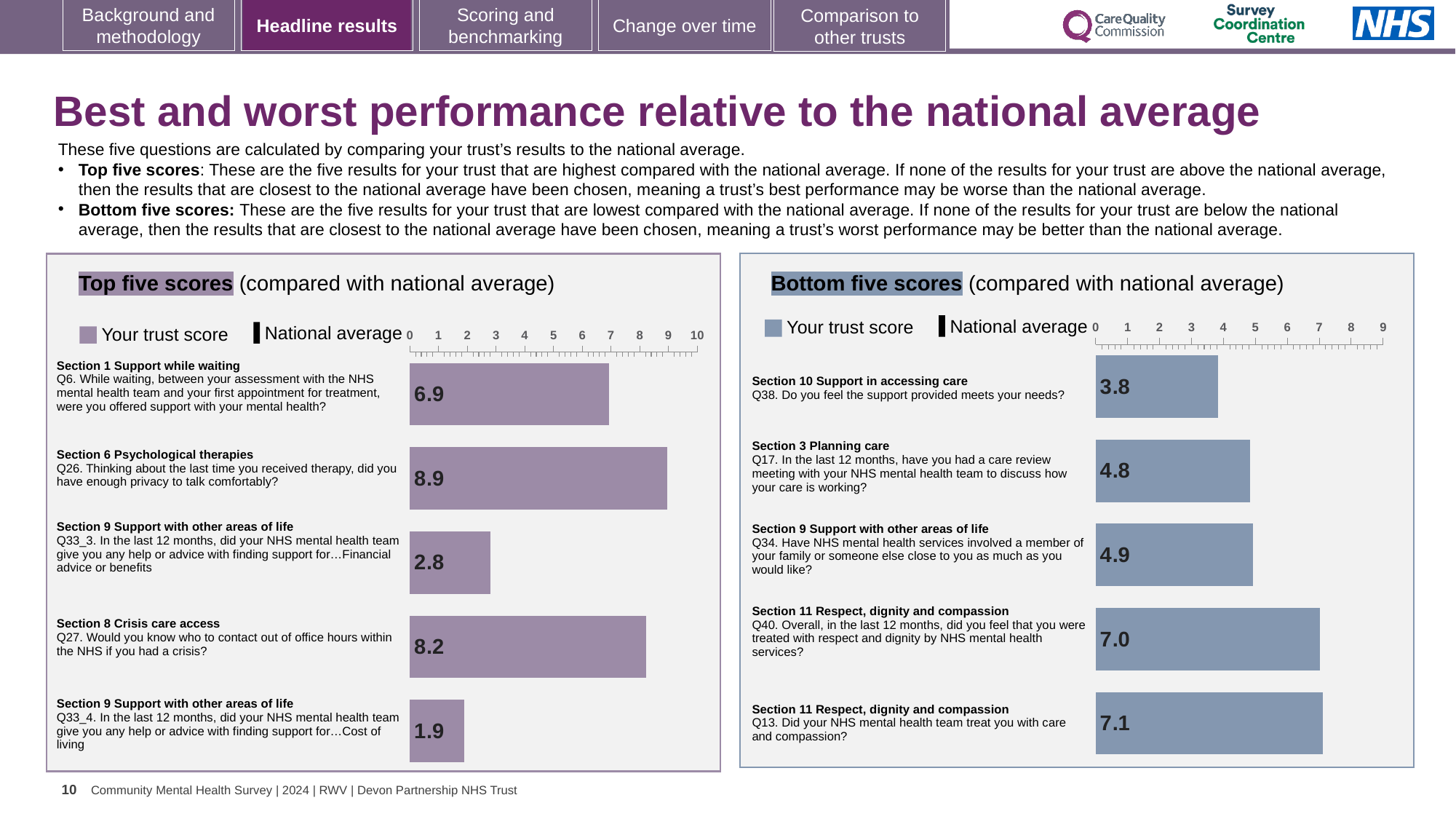
In the Top five scores chart, which question has the highest trust score? Q26 In the Bottom five scores chart, what is the difference between the scores for Q13 and Q38? 3.3 In the Top five scores chart, what is the trust score for Q26 (enough privacy to talk comfortably during therapy)? 8.9 In the Top five scores chart, which question has the lowest trust score? Q33_4 In the Bottom five scores chart, what is the trust score for Q38 (support provided meets your needs)? 3.8 In the Bottom five scores chart, which question has the lowest trust score? Q38 How many questions are shown in the Bottom five scores chart? 5 What type of chart is the Top five scores chart? Bar chart In the Top five scores chart, what is the difference between the scores for Q26 and Q33_4? 7.0 In the Top five scores chart, which has the larger score: Q27 or Q33_3? Q27 In the Top five scores chart, what is the trust score for Q6 (support while waiting between assessment and first appointment)? 6.9 In the Bottom five scores chart, what is the trust score for Q13 (treated with care and compassion)? 7.1